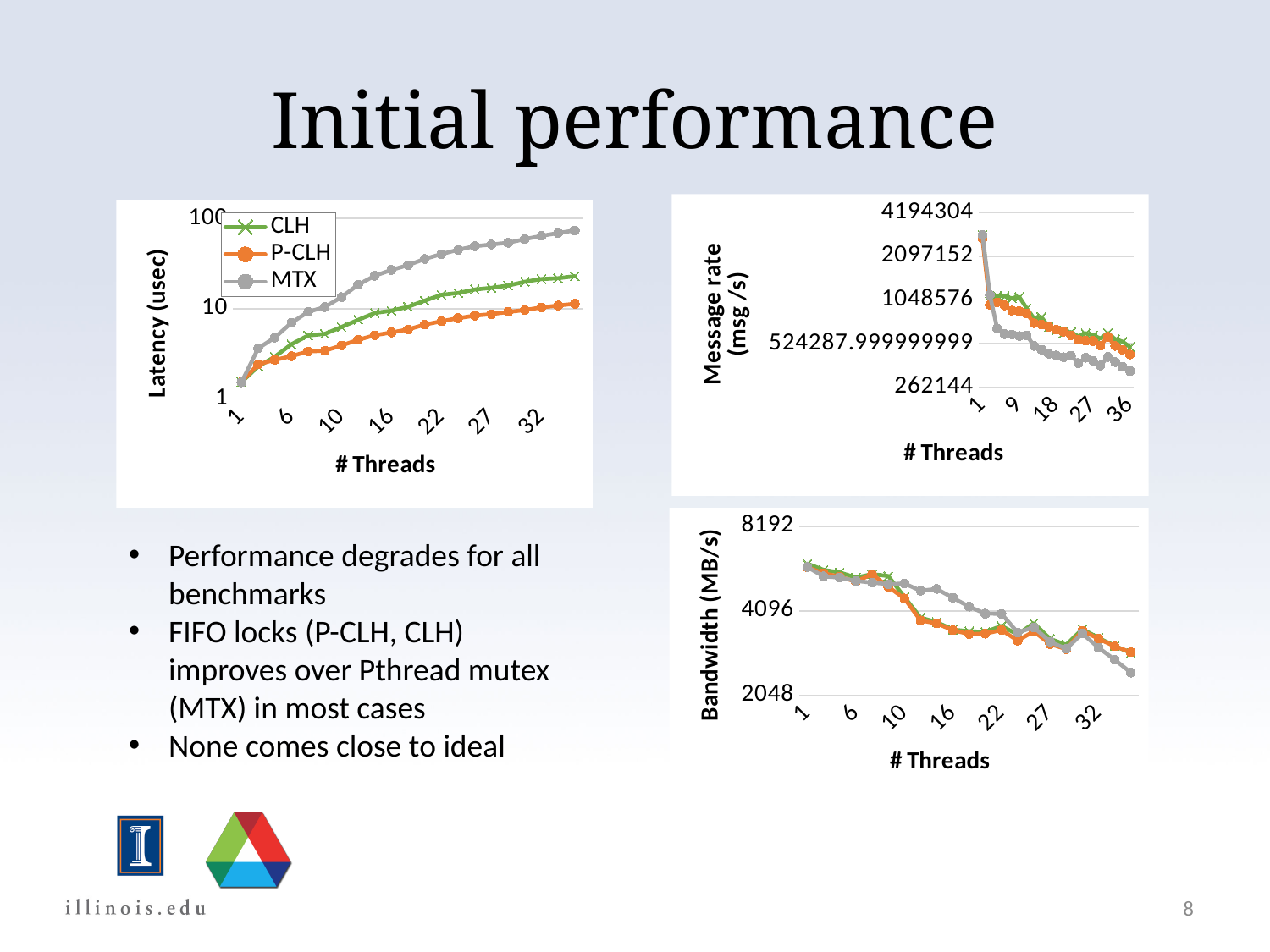
In the Latency (usec) chart, do the latency values rise or fall as the number of threads increases? rise How many series does the legend of the Latency (usec) chart list? 3 In the Latency (usec) chart, which series has the lowest latency at 32 threads? P-CLH In the Message rate (msg/s) chart, do the values rise or fall as the number of threads increases? fall What kind of chart is the Latency (usec) chart on the left of the slide? line chart In the Latency (usec) chart, which series is drawn with x-shaped markers? CLH In the Bandwidth (MB/s) chart, is the CLH value at 1 thread greater or less than 4096? greater In the Message rate (msg/s) chart, which series has the lowest message rate at 36 threads? MTX In the Bandwidth (MB/s) chart, is the MTX value at the highest thread count greater or less than 4096? less In the Latency (usec) chart, which series has the highest latency at 32 threads? MTX In the Latency (usec) chart, is the MTX value at 32 threads greater or less than 10? greater In the Bandwidth (MB/s) chart, which is larger at the highest thread count, the P-CLH value or the MTX value? P-CLH